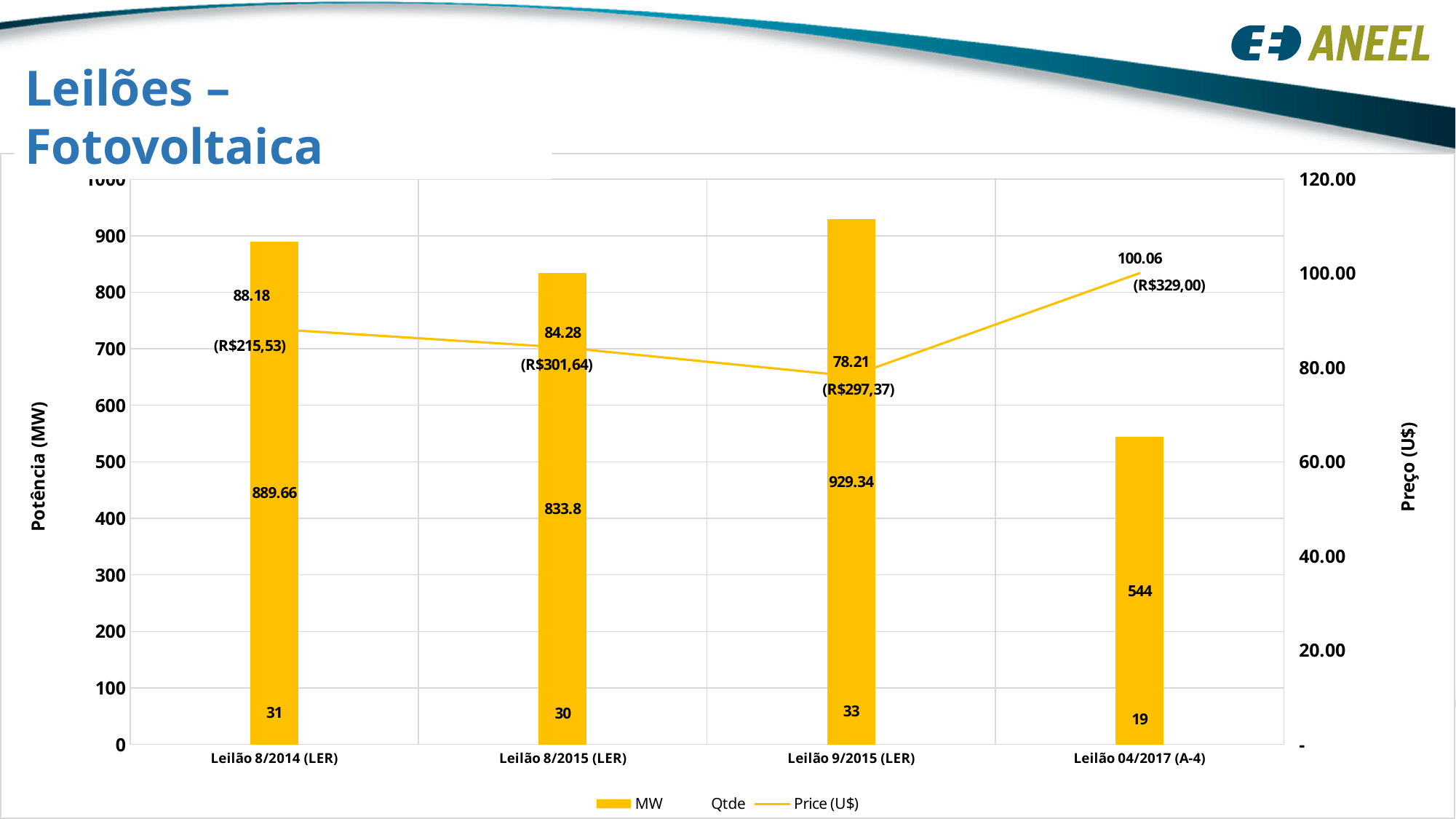
What is the MW value for Leilão 9/2015 (LER)? 929.34 What is the MW value for Leilão 04/2017 (A-4)? 544 Which auction has the highest MW value? Leilão 9/2015 (LER) Which auction has the lowest Price (U$) value? Leilão 9/2015 (LER) What is the label of the right-hand vertical axis? Preço (U$) What kind of chart is used to show the MW series? Bar chart How many series does the legend list? 3 What is the Qtde value for Leilão 8/2014 (LER)? 31 What is the Price (U$) value for Leilão 8/2015 (LER)? 84.28 How many auctions are shown on the x axis? 4 What is the difference in MW between Leilão 9/2015 (LER) and Leilão 04/2017 (A-4)? 385.34 Which is larger, the Price (U$) for Leilão 8/2014 (LER) or for Leilão 04/2017 (A-4)? Leilão 04/2017 (A-4)